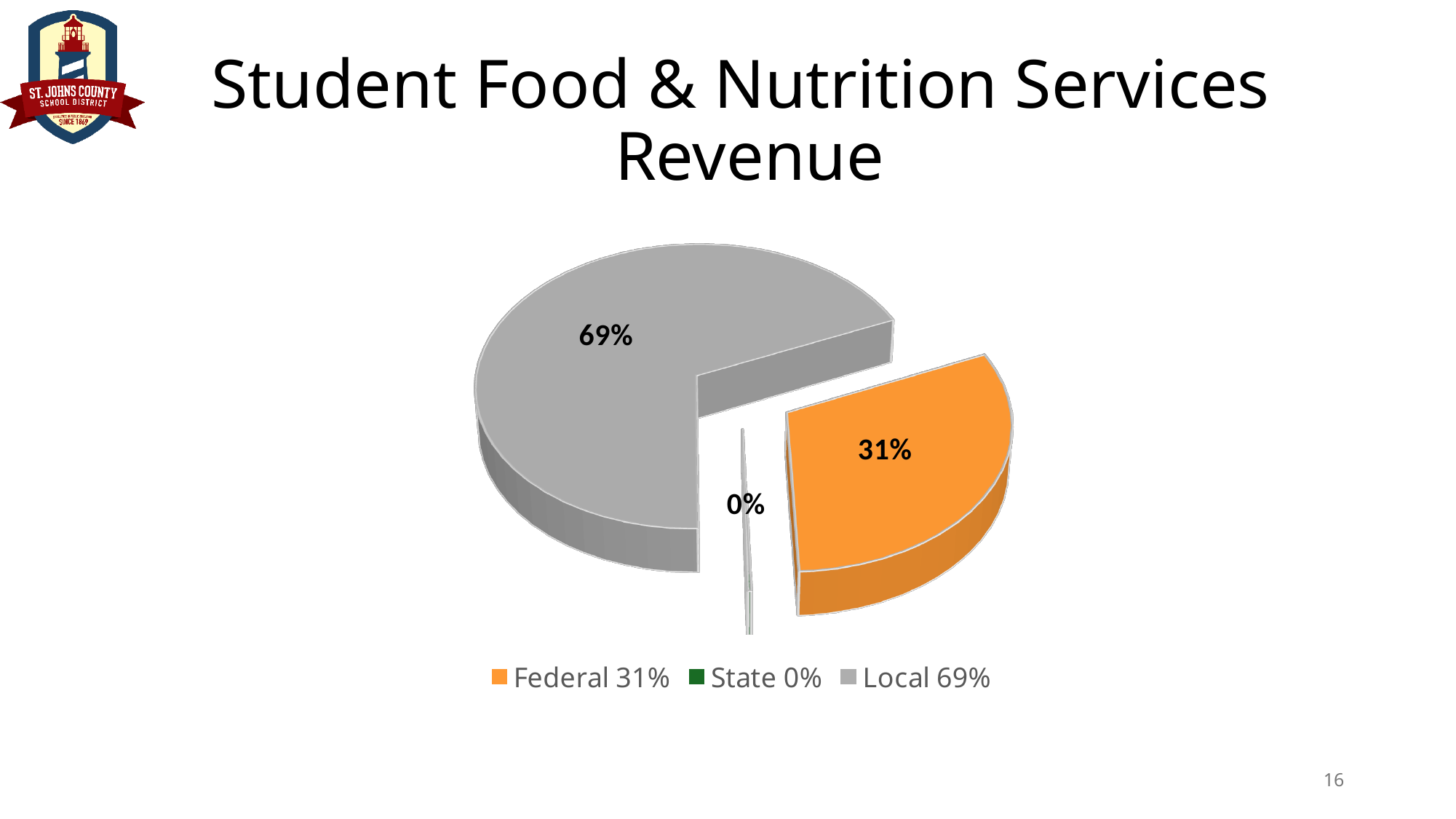
What share of Student Food & Nutrition Services Revenue comes from State sources? 0% Which revenue source has the largest share of the pie? Local What share of Student Food & Nutrition Services Revenue comes from Local sources? 69% What colour is the Federal slice of the pie? orange What is the difference in percentage points between the Local and Federal shares? 38 How many entries does the legend list? 3 What kind of chart is shown on the slide? pie chart Which revenue source has the smallest share of the pie? State What share of Student Food & Nutrition Services Revenue comes from Federal sources? 31% What is the title of the slide containing the pie chart? Student Food & Nutrition Services Revenue How many slices (categories) does the pie chart have? 3 Which is larger, the Federal share or the Local share? Local